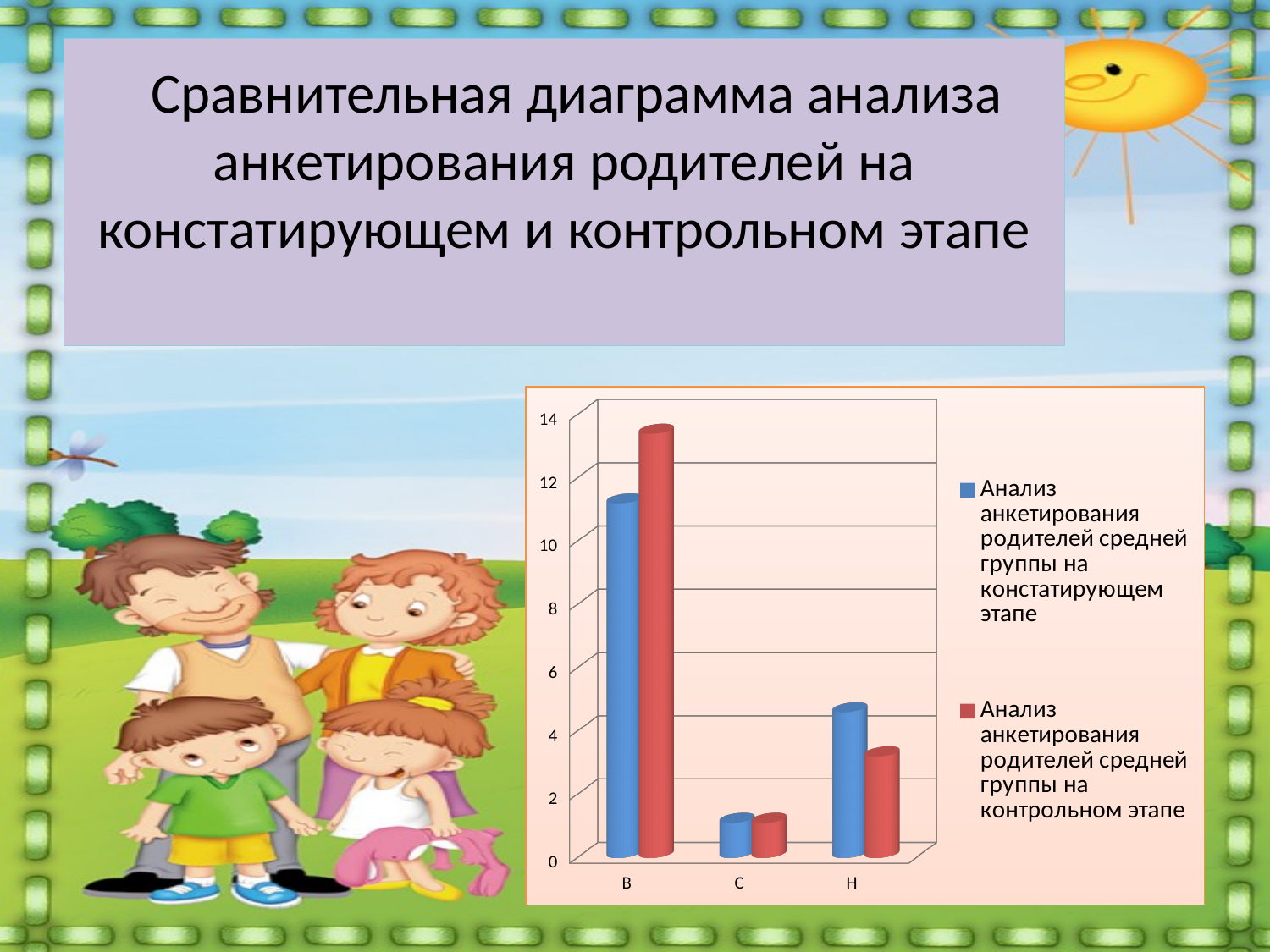
How many series does the chart's legend list? 2 For category Н, which series has the larger value: the констатирующий этап series or the контрольный этап series? констатирующий этап What colour are the bars for the series 'Анализ анкетирования родителей средней группы на контрольном этапе'? red Is the value for В in the series 'Анализ анкетирования родителей средней группы на констатирующем этапе' greater or less than 10? greater What kind of chart is shown on the slide? bar chart How many categories are shown on the x axis of the chart? 3 Is the value for С in the series 'Анализ анкетирования родителей средней группы на констатирующем этапе' greater or less than 2? less For category В, which series has the larger value: the констатирующий этап series or the контрольный этап series? контрольный этап Which category has the highest value for the series 'Анализ анкетирования родителей средней группы на констатирующем этапе'? В Is the value for В in the series 'Анализ анкетирования родителей средней группы на контрольном этапе' greater or less than 12? greater Which category has the lowest value for the series 'Анализ анкетирования родителей средней группы на контрольном этапе'? С